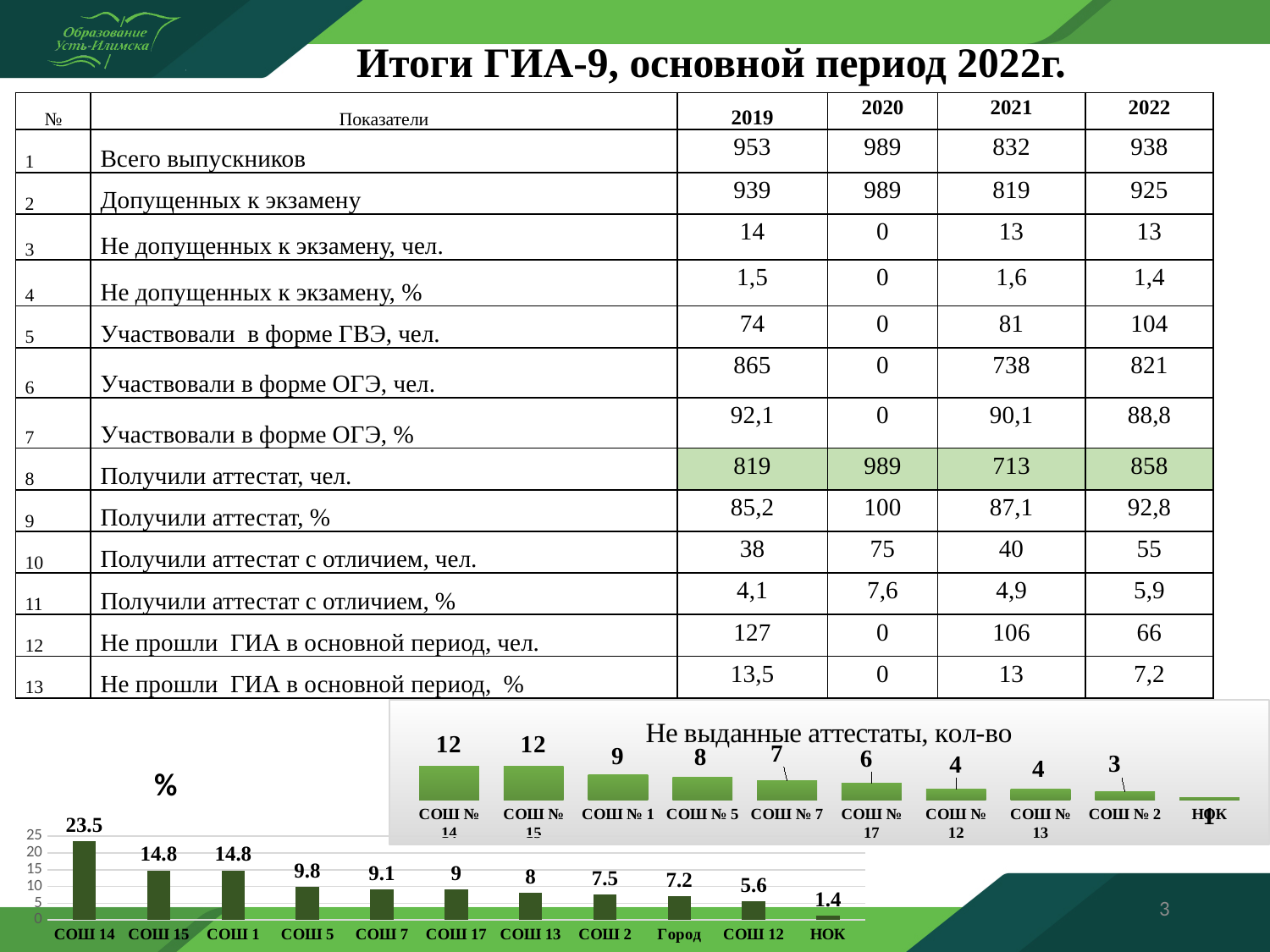
In the chart titled "%", which category has the highest value? СОШ 14 In the chart titled "%", what is the difference between the values for СОШ 14 and СОШ 15? 8.7 In the chart titled "%", which is larger, the value for СОШ 5 or the value for СОШ 12? СОШ 5 In the chart titled "%", what is the value for СОШ 14? 23.5 In the chart titled "%", what is the value for Город? 7.2 In the chart titled "Не выданные аттестаты, кол-во", what is the value for СОШ № 17? 6 In the chart titled "Не выданные аттестаты, кол-во", what is the value for СОШ № 1? 9 In the chart titled "Не выданные аттестаты, кол-во", how many categories are shown? 10 In the chart titled "Не выданные аттестаты, кол-во", which category has the lowest value? НОК In the chart titled "Не выданные аттестаты, кол-во", what is the difference between the values for СОШ № 14 and СОШ № 2? 9 What type of chart is the chart titled "%"? Bar chart In the chart titled "%", how many categories are shown? 11